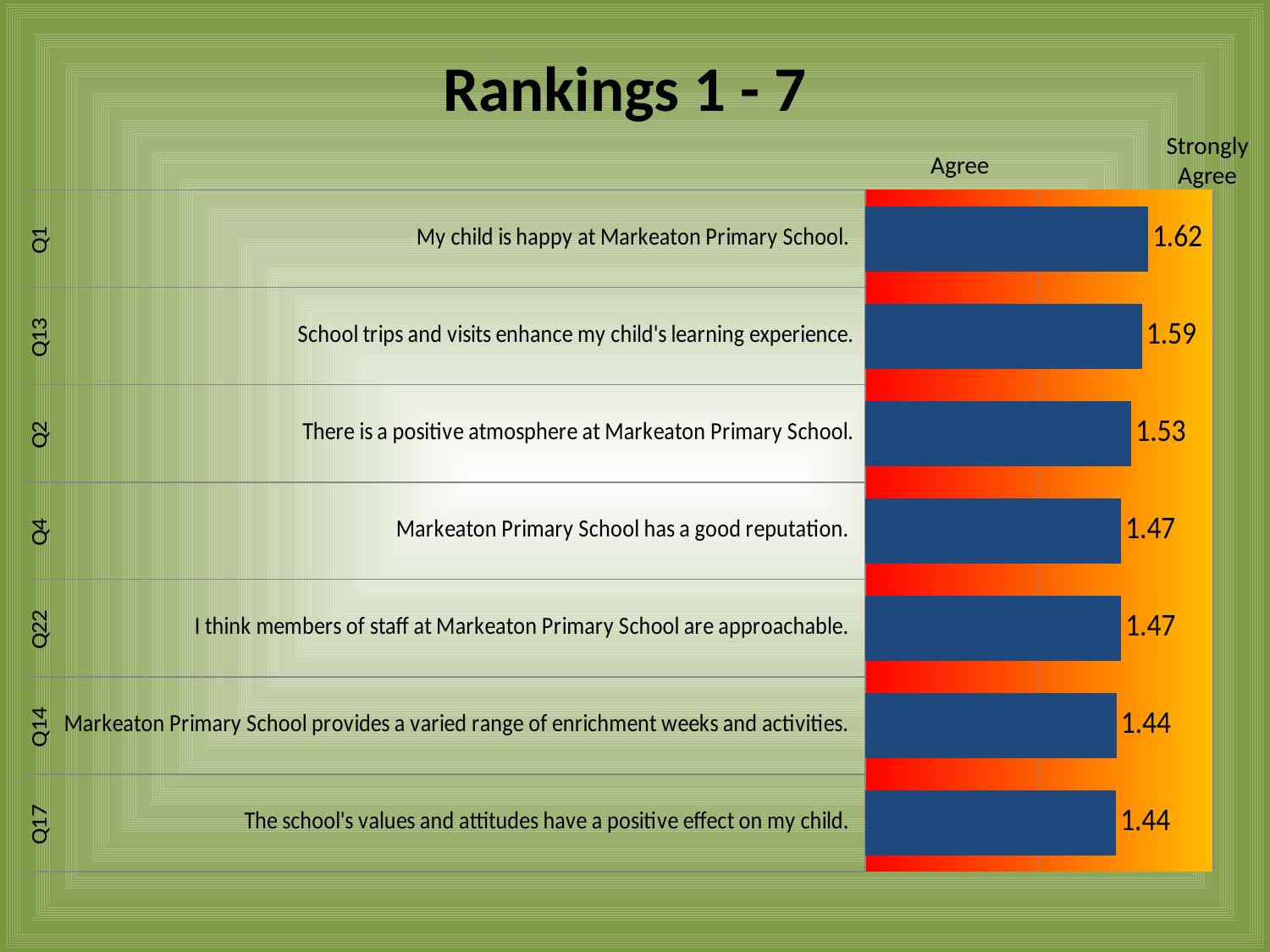
What is the value for Q2, "There is a positive atmosphere at Markeaton Primary School."? 1.53 Which has a larger value, Q2 or Q4? Q2 What is the value for Q13, "School trips and visits enhance my child's learning experience."? 1.59 Which question has the highest value on the chart? Q1 How many questions (bars) are shown on the chart? 7 What kind of chart is shown on the slide? Bar chart What is the value for Q14, "Markeaton Primary School provides a varied range of enrichment weeks and activities."? 1.44 What is the value for Q1, "My child is happy at Markeaton Primary School."? 1.62 Do the values rise or fall going down the chart from Q1 to Q17? Fall What is the title of the slide? Rankings 1 - 7 What is the difference between the values for Q1 and Q17? 0.18 What is the difference between the values for Q13 and Q2? 0.06